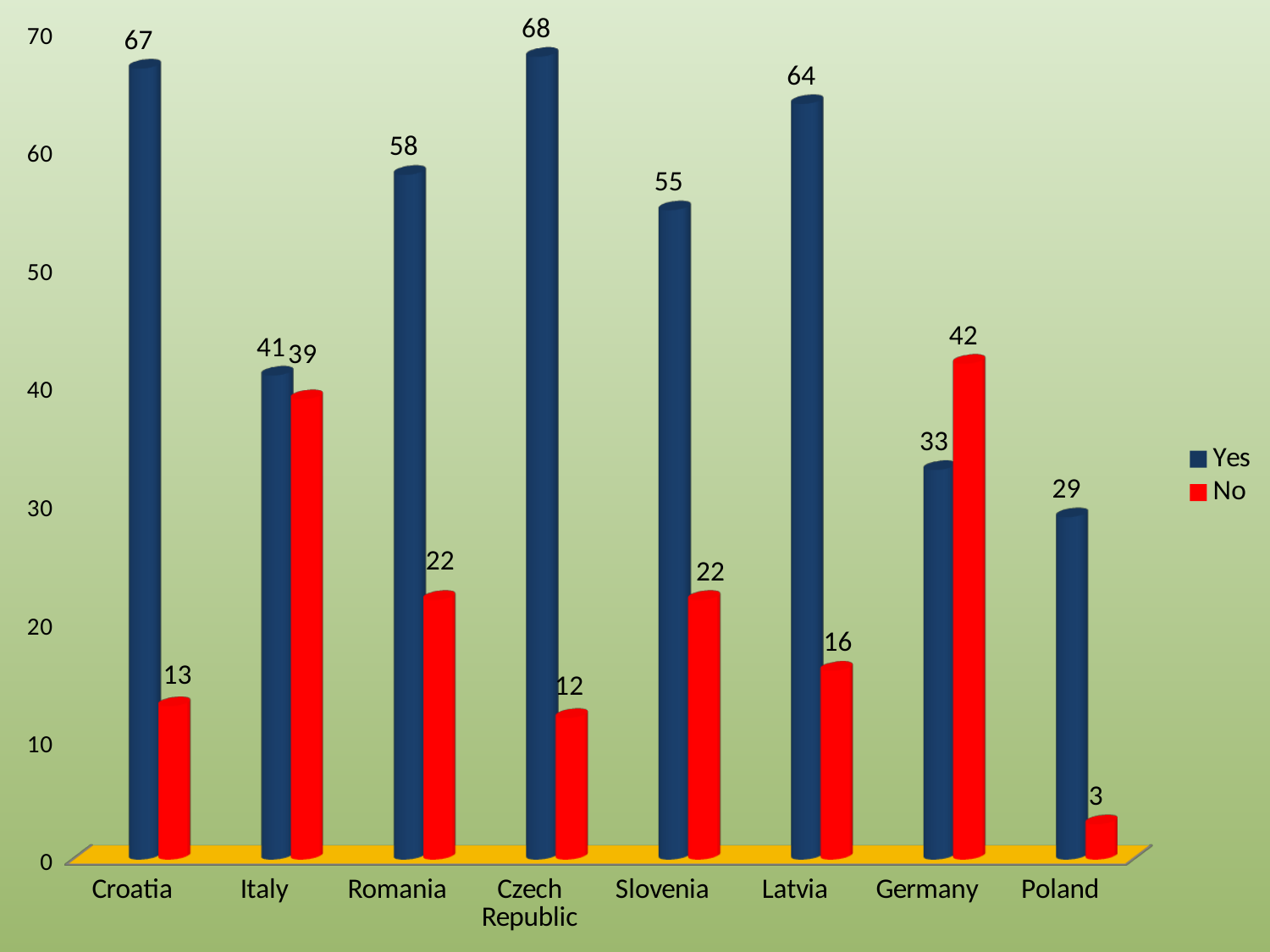
What is the difference between the Yes and No values for Italy? 2 What is the No value for Germany? 42 What is the difference between the Yes values for Latvia and Germany? 31 What is the No value for Poland? 3 Which country has the highest Yes value? Czech Republic How many countries are shown on the x axis? 8 What is the Yes value for Croatia? 67 How many series does the legend list? 2 Which is larger for Germany, the Yes value or the No value? No Which country has the lowest No value? Poland What kind of chart is shown on the slide? Bar chart What colour are the No bars? Red